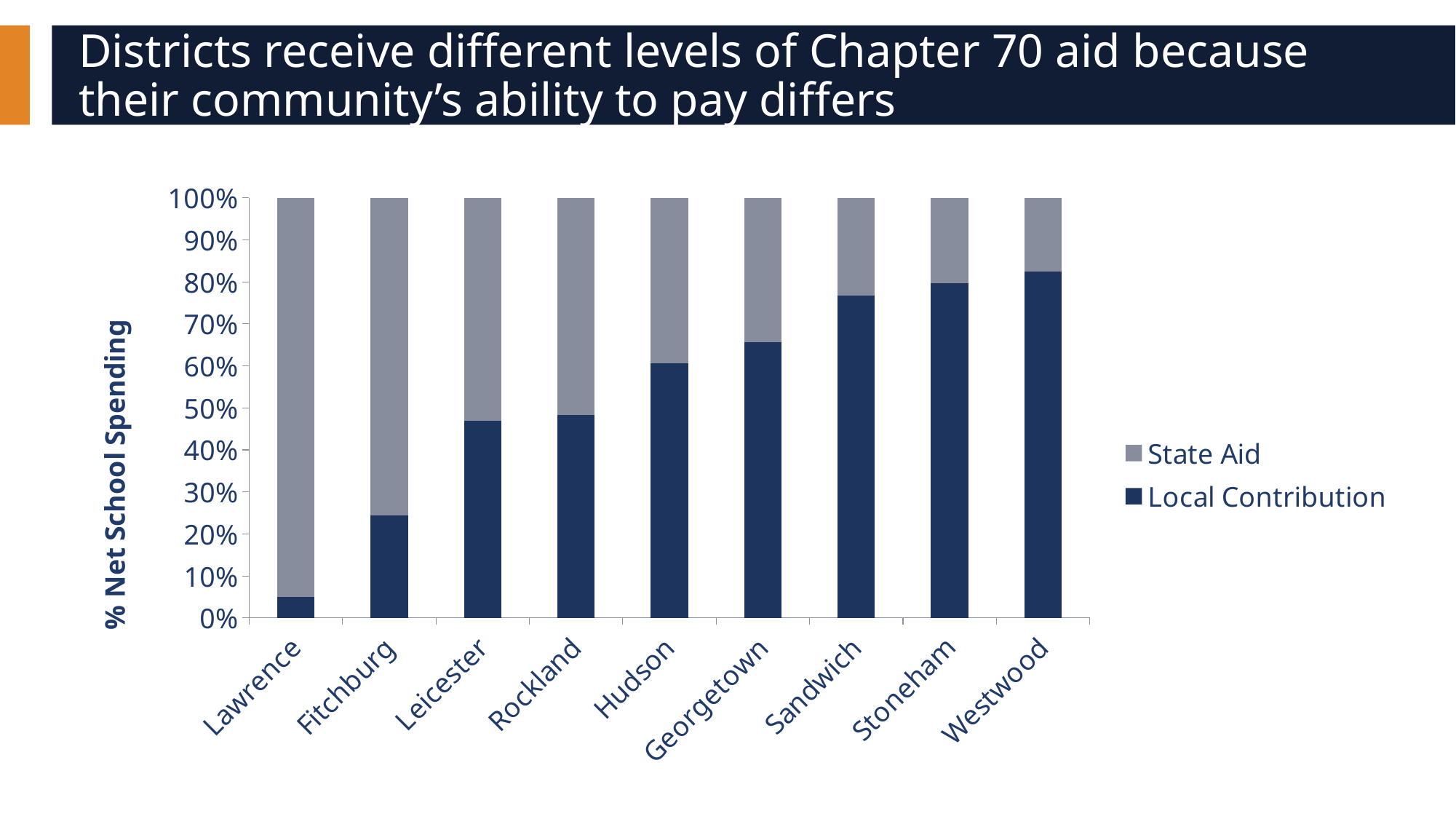
Is the Local Contribution value for Lawrence greater or less than 10%? less Is the Local Contribution value for Hudson greater or less than 50%? greater How many series does the chart's legend list? 2 How many districts are shown on the x axis of the chart? 9 Does the Local Contribution share rise or fall moving from Lawrence to Westwood along the x axis? Rises Is the Local Contribution value for Sandwich greater or less than 70%? greater Which district has the highest Local Contribution share? Westwood Which district has the largest State Aid share? Lawrence What kind of chart is shown on the slide? Stacked bar chart Which district has a larger Local Contribution share, Fitchburg or Hudson? Hudson Which district has the lowest Local Contribution share? Lawrence